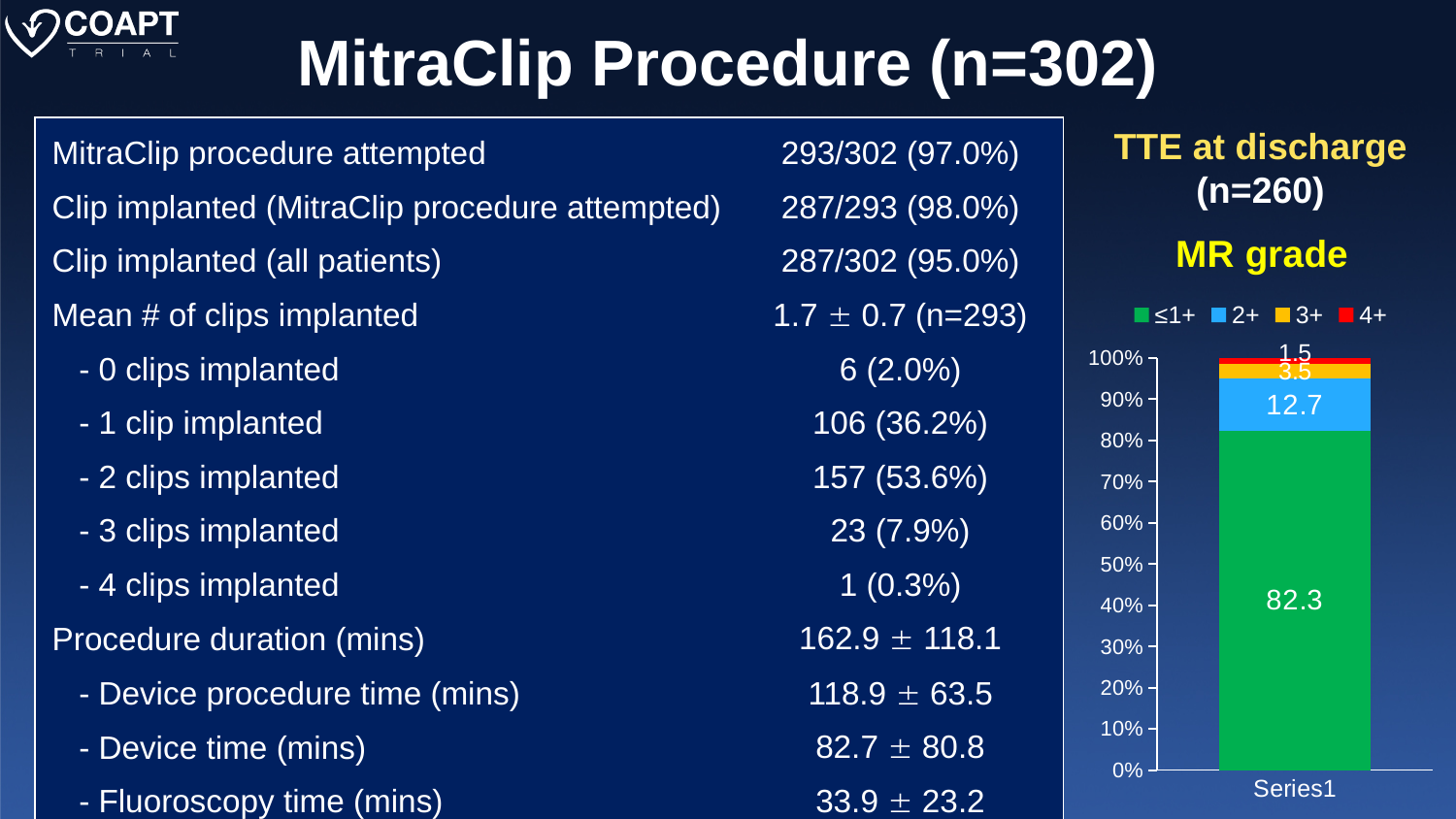
What is the value of the 4+ segment in the MR grade stacked bar? 1.5 How many series does the legend of the MR grade chart list? 4 Which is larger in the MR grade chart, the 3+ segment or the 4+ segment? 3+ What is the value of the ≤1+ segment in the MR grade stacked bar? 82.3 What is the sample size shown in the title of the TTE at discharge chart? n=260 Which MR grade has the smallest segment in the stacked bar? 4+ What is the difference between the ≤1+ and 2+ segment values in the MR grade chart? 69.6 What is the value of the 2+ segment in the MR grade stacked bar? 12.7 What kind of chart is used to show MR grade at discharge? Stacked bar chart What is the value of the 3+ segment in the MR grade stacked bar? 3.5 What is the total of all segments in the MR grade stacked bar? 100 Which MR grade has the largest segment in the stacked bar? ≤1+